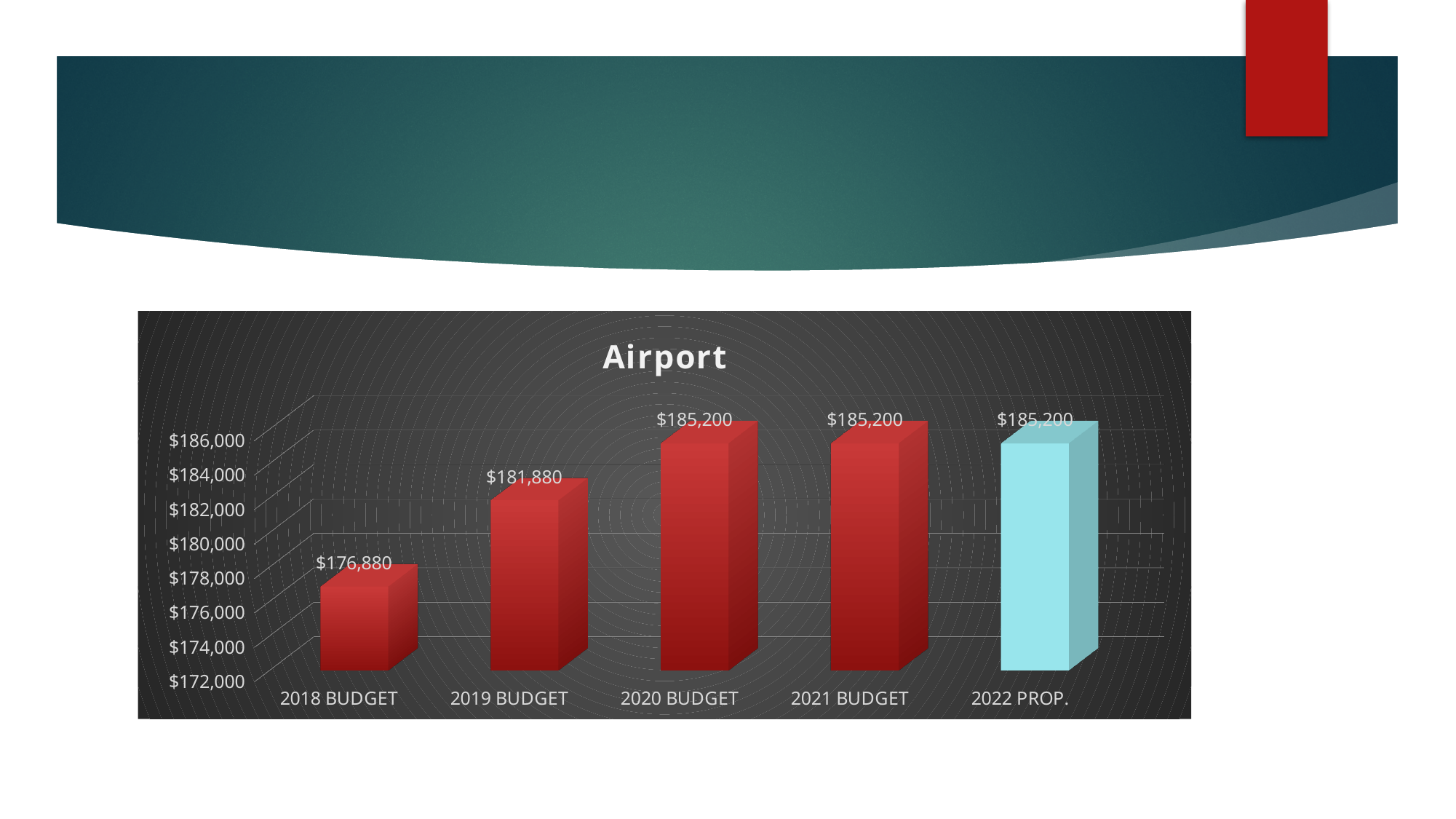
Which is larger, the value for 2019 BUDGET or the value for 2020 BUDGET? 2020 BUDGET Is the value for 2018 BUDGET greater or less than $178,000? less What kind of chart is shown on the slide? bar chart What is the value for 2022 PROP. in the Airport chart? $185,200 What is the value for 2019 BUDGET in the Airport chart? $181,880 What is the value for 2018 BUDGET in the Airport chart? $176,880 How many categories are shown in the Airport chart? 5 What is the difference between the 2019 BUDGET and 2018 BUDGET values? $5,000 Do the values rise or fall from 2018 BUDGET to 2020 BUDGET? rise What is the difference between the 2020 BUDGET and 2019 BUDGET values? $3,320 Which category has the lowest value in the Airport chart? 2018 BUDGET What is the title of the chart? Airport